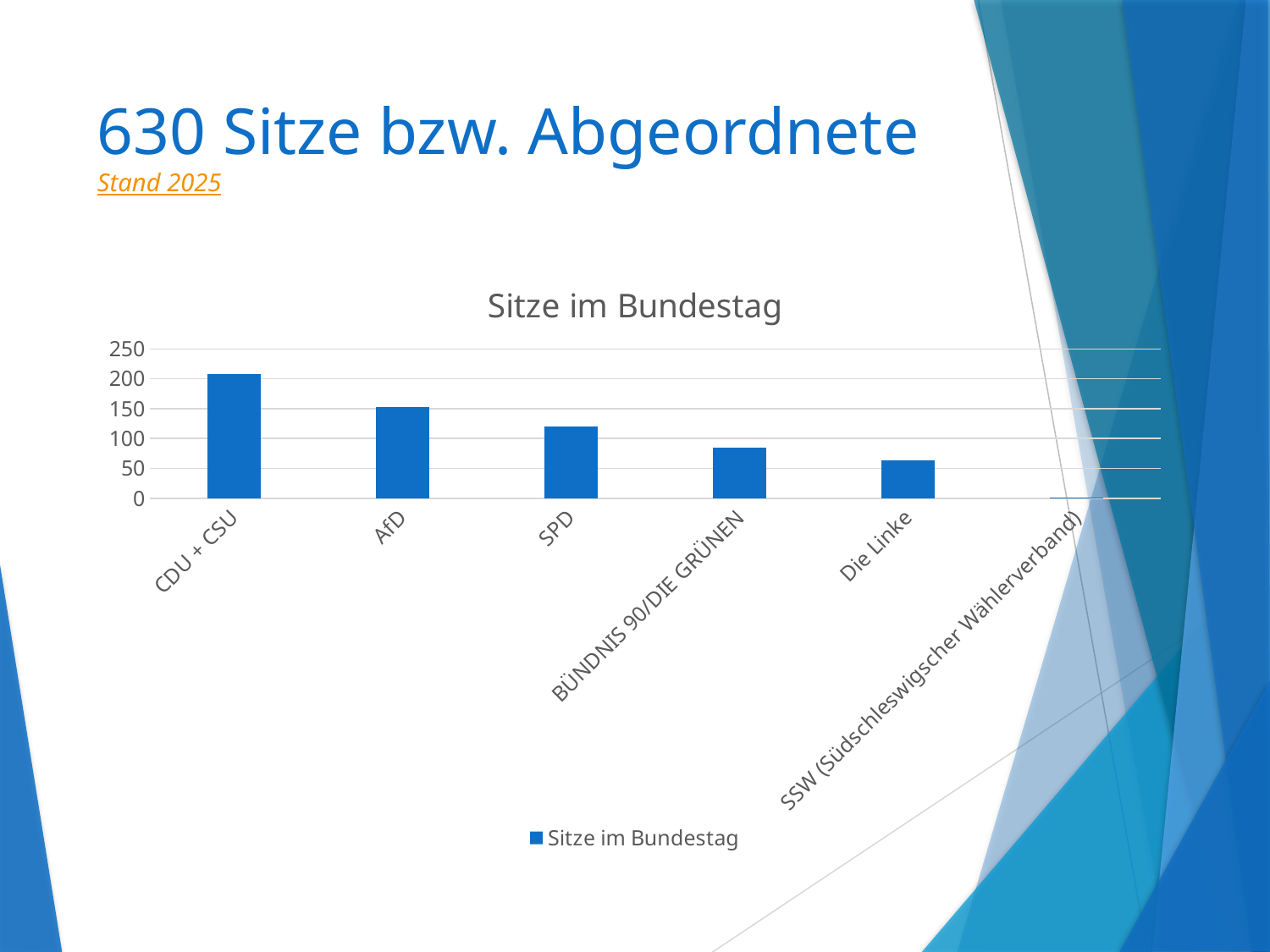
What is the title of the chart? Sitze im Bundestag How many parties (categories) are shown on the x axis of the chart? 6 Which has more seats in the chart, BÜNDNIS 90/DIE GRÜNEN or Die Linke? BÜNDNIS 90/DIE GRÜNEN Which has more seats in the chart, AfD or SPD? AfD How many series does the chart legend list? 1 Is the value for SPD greater or less than 100? greater Which party has the highest number of seats in the chart? CDU + CSU What kind of chart is shown on the slide? bar chart Which party has the lowest number of seats in the chart? SSW (Südschleswigscher Wählerverband) Is the value for BÜNDNIS 90/DIE GRÜNEN greater or less than 100? less Is the value for CDU + CSU greater or less than 150? greater Do the values rise or fall from left to right along the x axis? fall